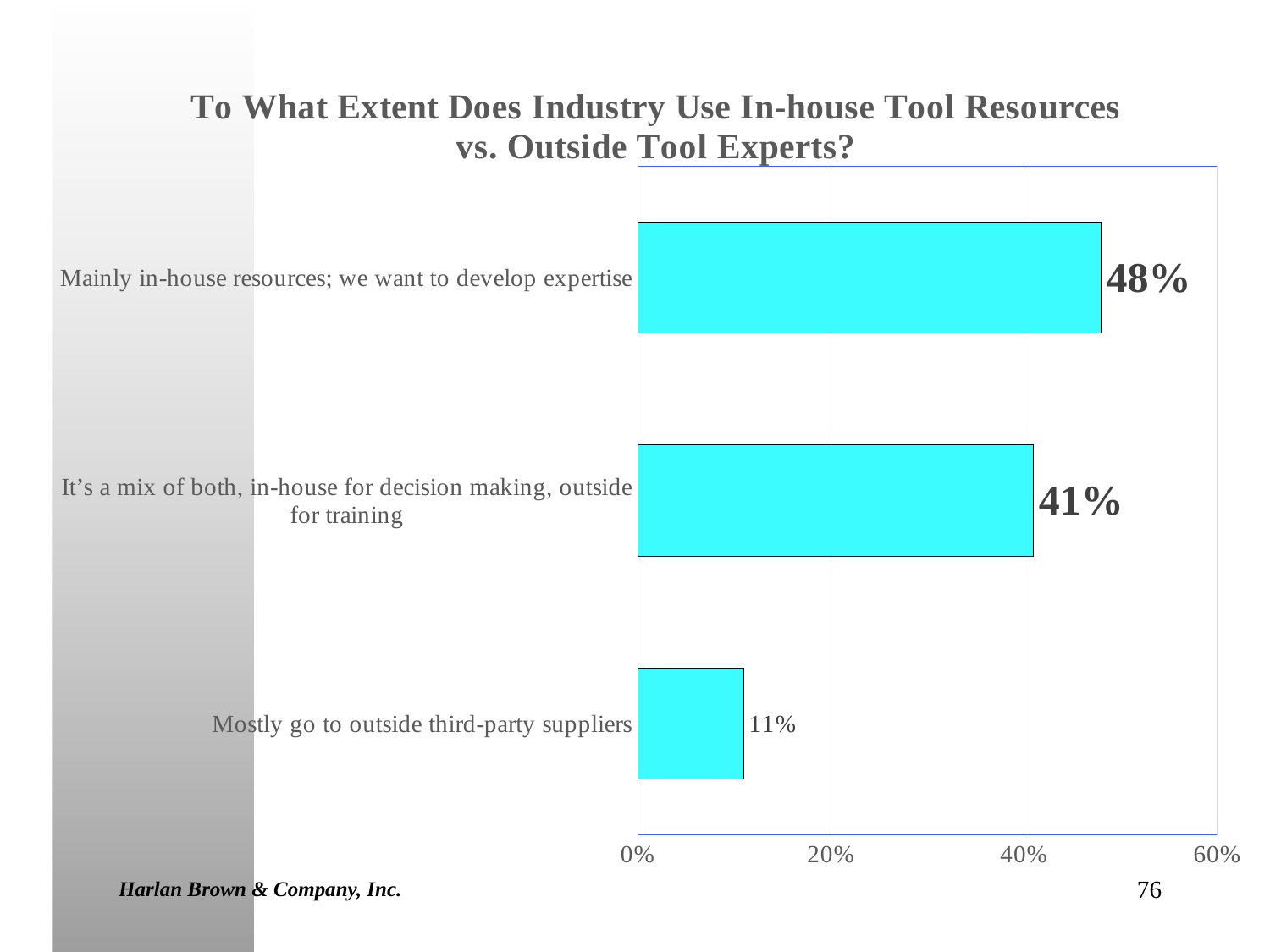
Which is larger: the value for "It's a mix of both" or the value for "Mostly go to outside third-party suppliers"? It's a mix of both What percentage of respondents mostly go to outside third-party suppliers? 11% What percentage of respondents said they mainly use in-house resources to develop expertise? 48% How many categories are shown in the chart? 3 What type of chart is shown on the slide? Bar chart What is the title of the chart? To What Extent Does Industry Use In-house Tool Resources vs. Outside Tool Experts? What is the value for "It's a mix of both, in-house for decision making, outside for training"? 41% What is the difference in percentage points between "Mainly in-house resources" and "Mostly go to outside third-party suppliers"? 37 percentage points What is the difference between the "Mainly in-house resources" value and the "It's a mix of both" value? 7 percentage points Which category has the lowest value? Mostly go to outside third-party suppliers Which category has the highest value? Mainly in-house resources; we want to develop expertise Is the value for "It's a mix of both, in-house for decision making, outside for training" greater or less than 40%? greater